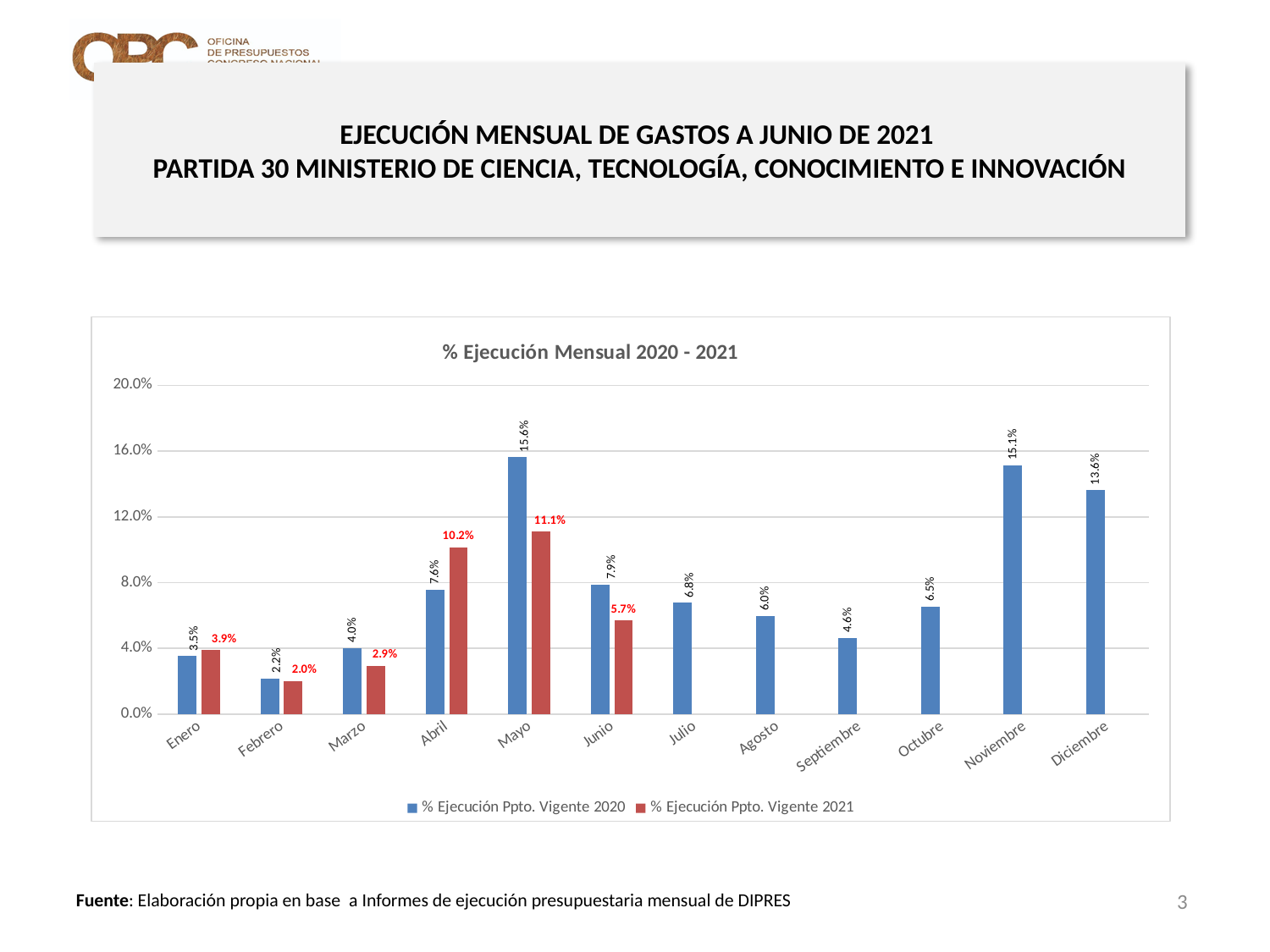
Which month has the highest value for % Ejecución Ppto. Vigente 2020? Mayo Which is larger in Abril: the 2020 value or the 2021 value? 2021 value (10.2%) How many series does the legend list? 2 Is the value for % Ejecución Ppto. Vigente 2020 in Noviembre greater or less than 12.0%? greater What is the title of the chart? % Ejecución Mensual 2020 - 2021 What is the value for % Ejecución Ppto. Vigente 2021 in Abril? 10.2% What is the value for % Ejecución Ppto. Vigente 2020 in Mayo? 15.6% How many months are shown on the x axis? 12 Which month has the lowest value for % Ejecución Ppto. Vigente 2021? Febrero What is the difference between the 2020 and 2021 values in Mayo? 4.5% What kind of chart is shown? Bar chart What is the value for % Ejecución Ppto. Vigente 2021 in Junio? 5.7%